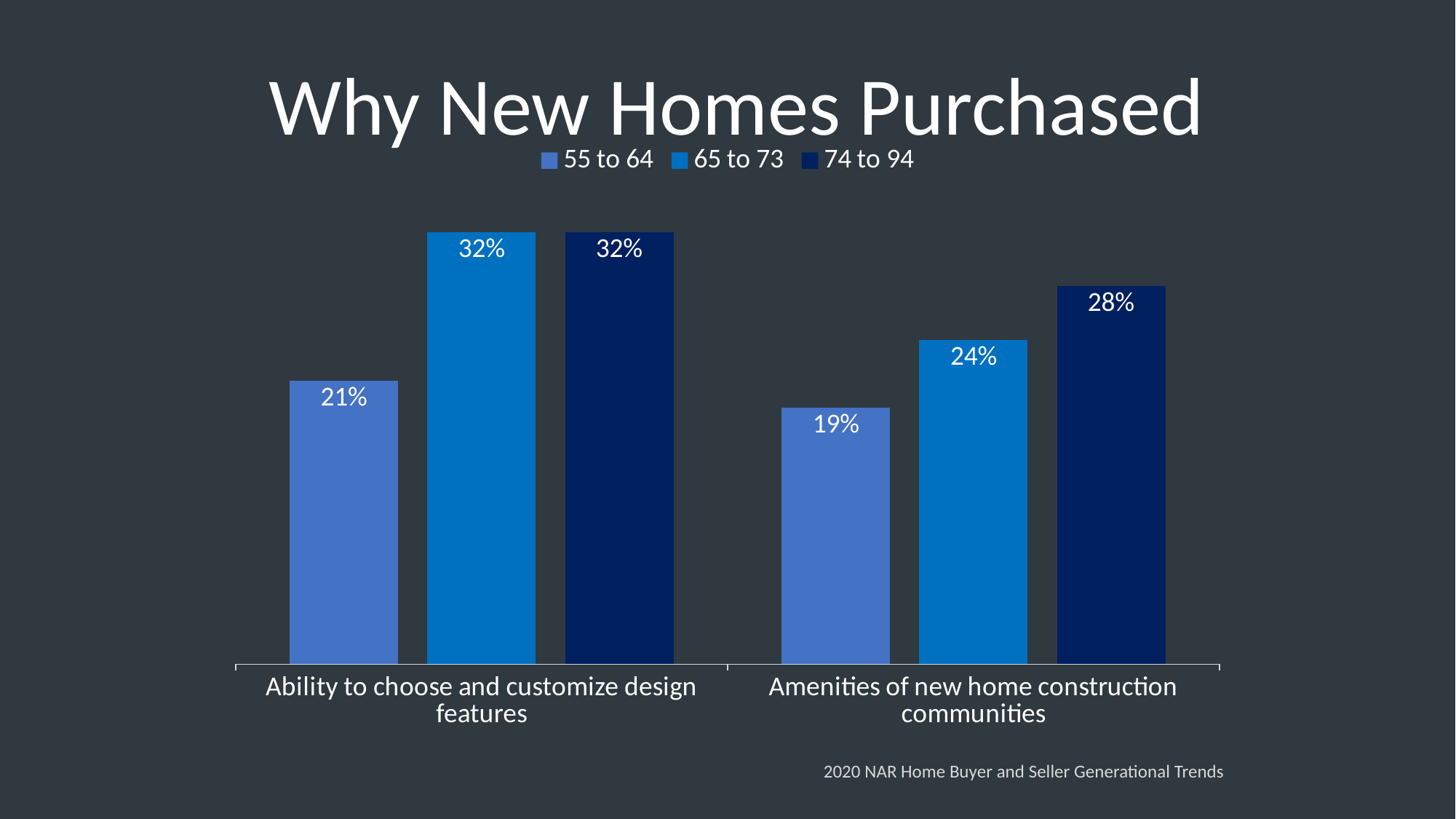
What is the value for the 55 to 64 series for 'Ability to choose and customize design features'? 21% Which is larger for the 55 to 64 group: 'Ability to choose and customize design features' or 'Amenities of new home construction communities'? Ability to choose and customize design features What is the difference between the 74 to 94 and 55 to 64 values for 'Amenities of new home construction communities'? 9% What is the value for the 65 to 73 series for 'Amenities of new home construction communities'? 24% What is the difference between the 65 to 73 and 55 to 64 values for 'Ability to choose and customize design features'? 11% How many categories are shown on the x axis? 2 What kind of chart is shown on the slide? Bar chart Which age group has the lowest value for 'Ability to choose and customize design features'? 55 to 64 What is the value for the 74 to 94 series for 'Amenities of new home construction communities'? 28% How many series does the legend list? 3 Which age group has the lowest value for 'Amenities of new home construction communities'? 55 to 64 What is the value for the 65 to 73 series for 'Ability to choose and customize design features'? 32%